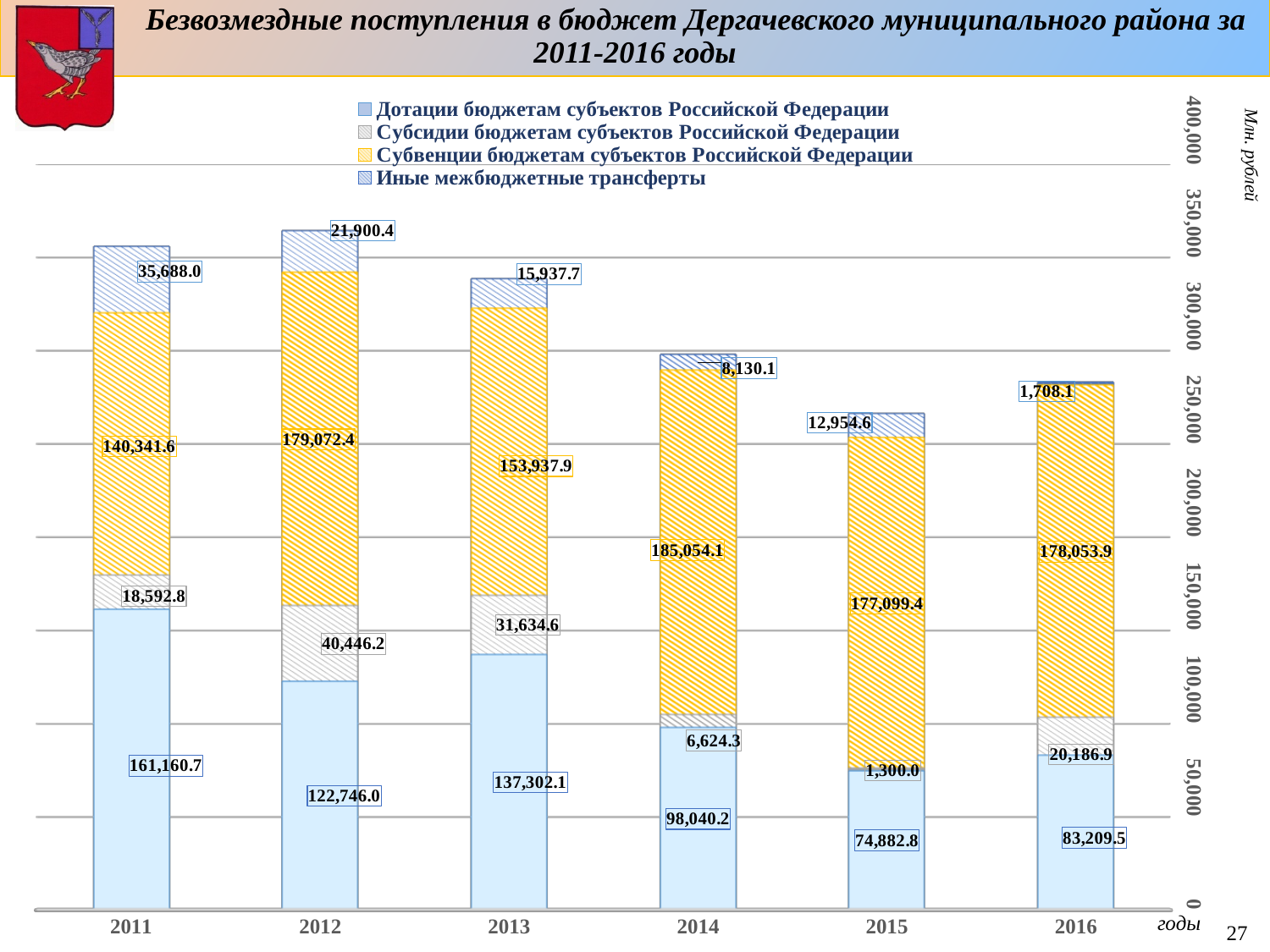
Which year has the larger value for Субсидии бюджетам субъектов Российской Федерации, 2012 or 2013? 2012 In which year is the value of Субвенции бюджетам субъектов Российской Федерации the highest? 2014 What is the difference between the Дотации values for 2011 and 2012? 38,414.7 How many series does the legend list? 4 What is the value of Субсидии бюджетам субъектов Российской Федерации for 2016? 20,186.9 What is the value of Иные межбюджетные трансферты for 2016? 1,708.1 How many years are shown on the x axis? 6 What kind of chart is shown on the slide? Stacked bar chart What is the value of Дотации бюджетам субъектов Российской Федерации for 2011? 161,160.7 Do the values of Дотации бюджетам субъектов Российской Федерации rise or fall from 2011 to 2015? Fall What is the value of Субвенции бюджетам субъектов Российской Федерации for 2014? 185,054.1 In which year is the value of Субсидии бюджетам субъектов Российской Федерации the lowest? 2015